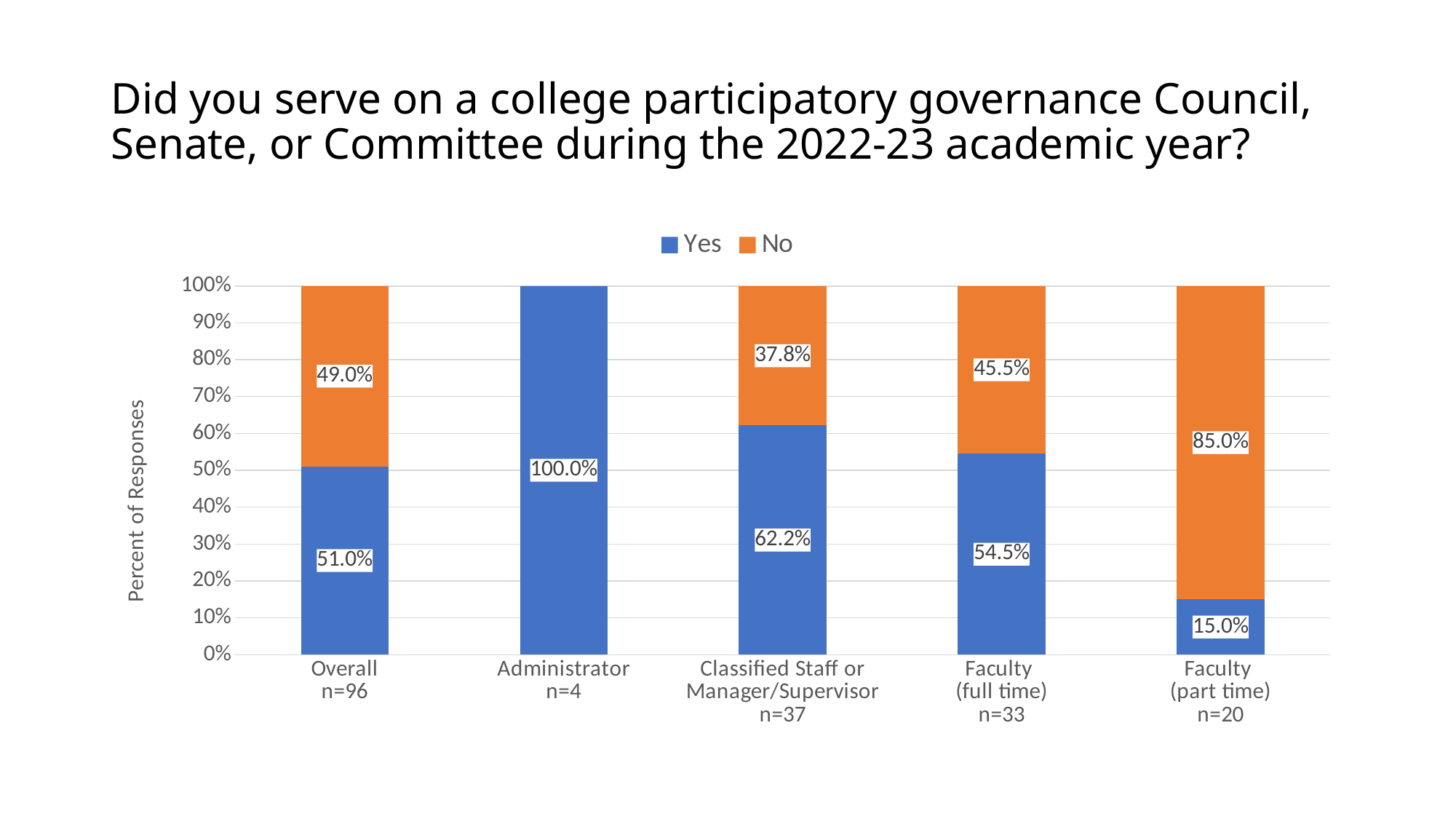
What is the difference between the Yes percentages for Classified Staff or Manager/Supervisor and Faculty (full time)? 7.7% Which group has the lowest Yes percentage? Faculty (part time) How many groups are shown on the x axis? 5 What percentage of Faculty (full time) respondents answered No? 45.5% Which is larger: the No percentage for Overall or the No percentage for Classified Staff or Manager/Supervisor? Overall What percentage of Faculty (part time) respondents answered No? 85.0% How many series does the legend list? 2 What is the sample size (n) for the Faculty (full time) group? 33 Which group has the highest Yes percentage? Administrator What percentage of Classified Staff or Manager/Supervisor respondents answered Yes? 62.2% What kind of chart is shown? Stacked bar chart What percentage of Overall respondents answered Yes? 51.0%